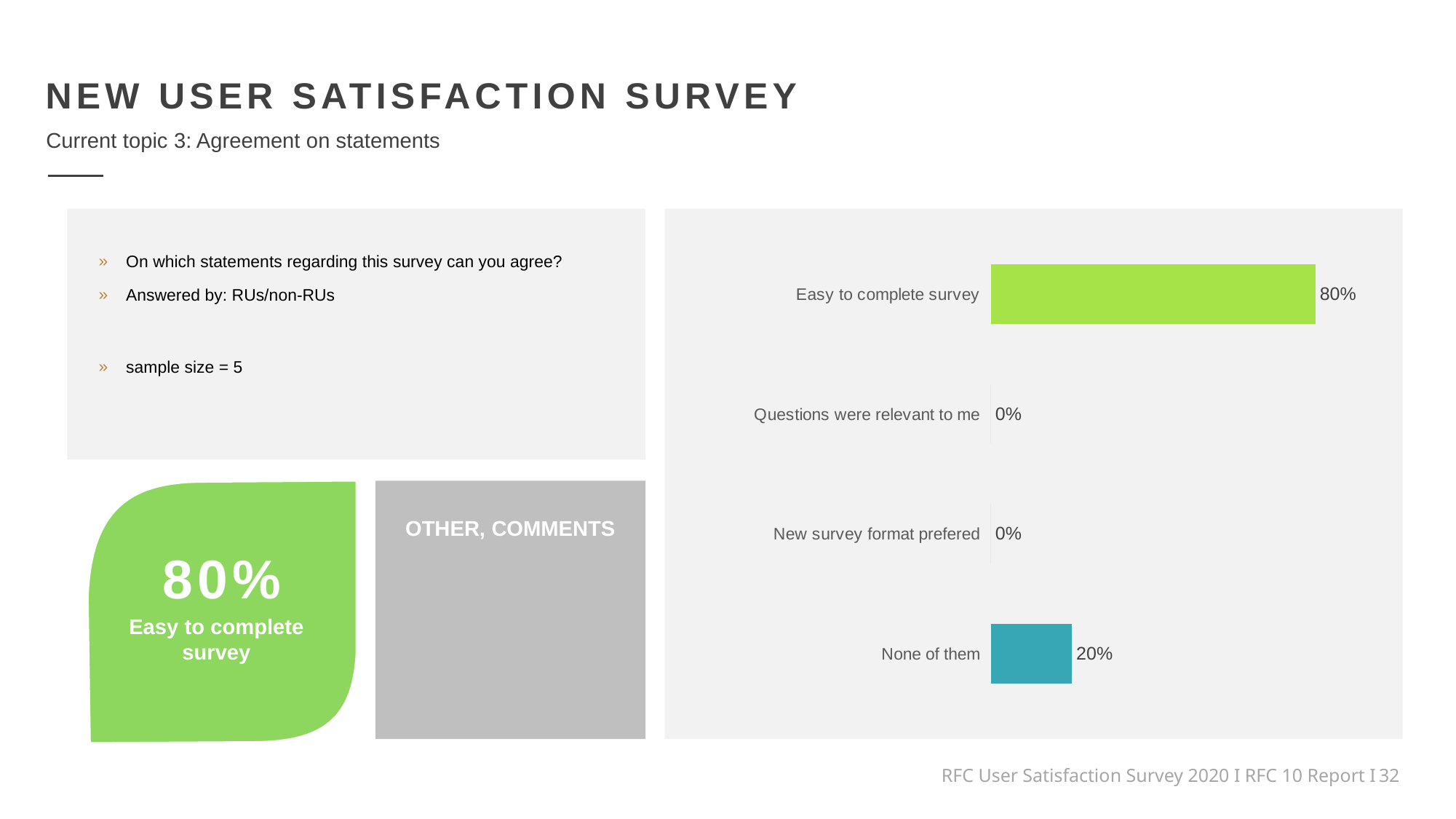
How many categories have a value of 0%? 2 Which category has the highest value? Easy to complete survey Which is larger, "None of them" or "New survey format prefered"? None of them What is the value for "None of them"? 20% What is the value for "New survey format prefered"? 0% What is the difference between "Easy to complete survey" and "None of them"? 60% What is the total of all four category values? 100% What is the value for "Questions were relevant to me"? 0% What colour is the bar for "None of them"? Teal What is the value for "Easy to complete survey"? 80% What kind of chart is shown on the slide? Bar chart How many categories are shown in the chart? 4